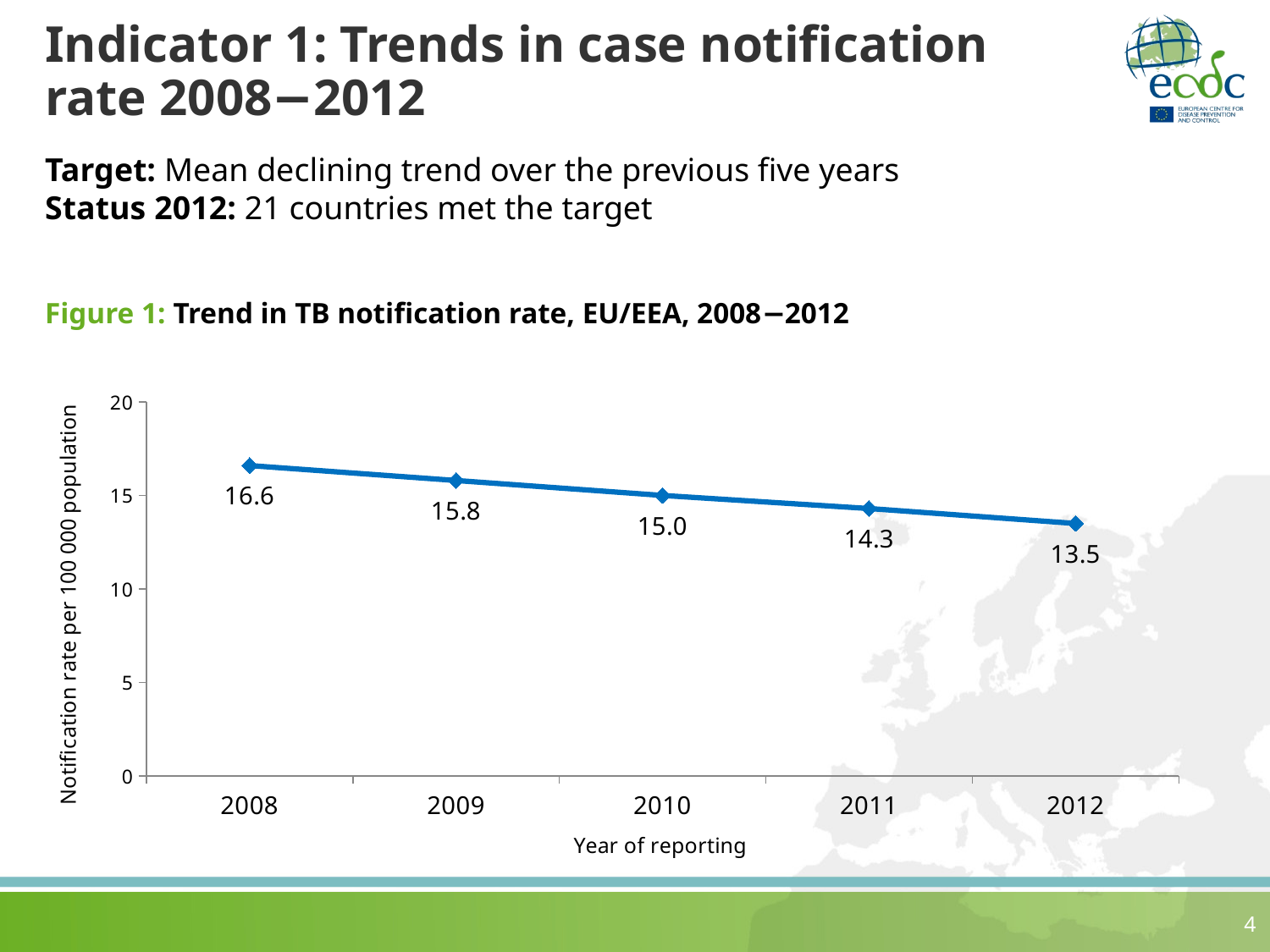
What kind of chart is shown? line chart Which year has the highest notification rate? 2008 What is the difference between the notification rate in 2008 and in 2012? 3.1 What is the difference between the notification rate in 2009 and in 2011? 1.5 What is the TB notification rate for 2012? 13.5 What is the TB notification rate for 2010? 15.0 Which year has the lowest notification rate? 2012 Does the notification rate rise or fall from 2008 to 2012? fall Which year has a higher notification rate, 2009 or 2011? 2009 Is the notification rate for 2012 greater or less than 15? less How many years are plotted on the chart? 5 What is the TB notification rate for 2008? 16.6